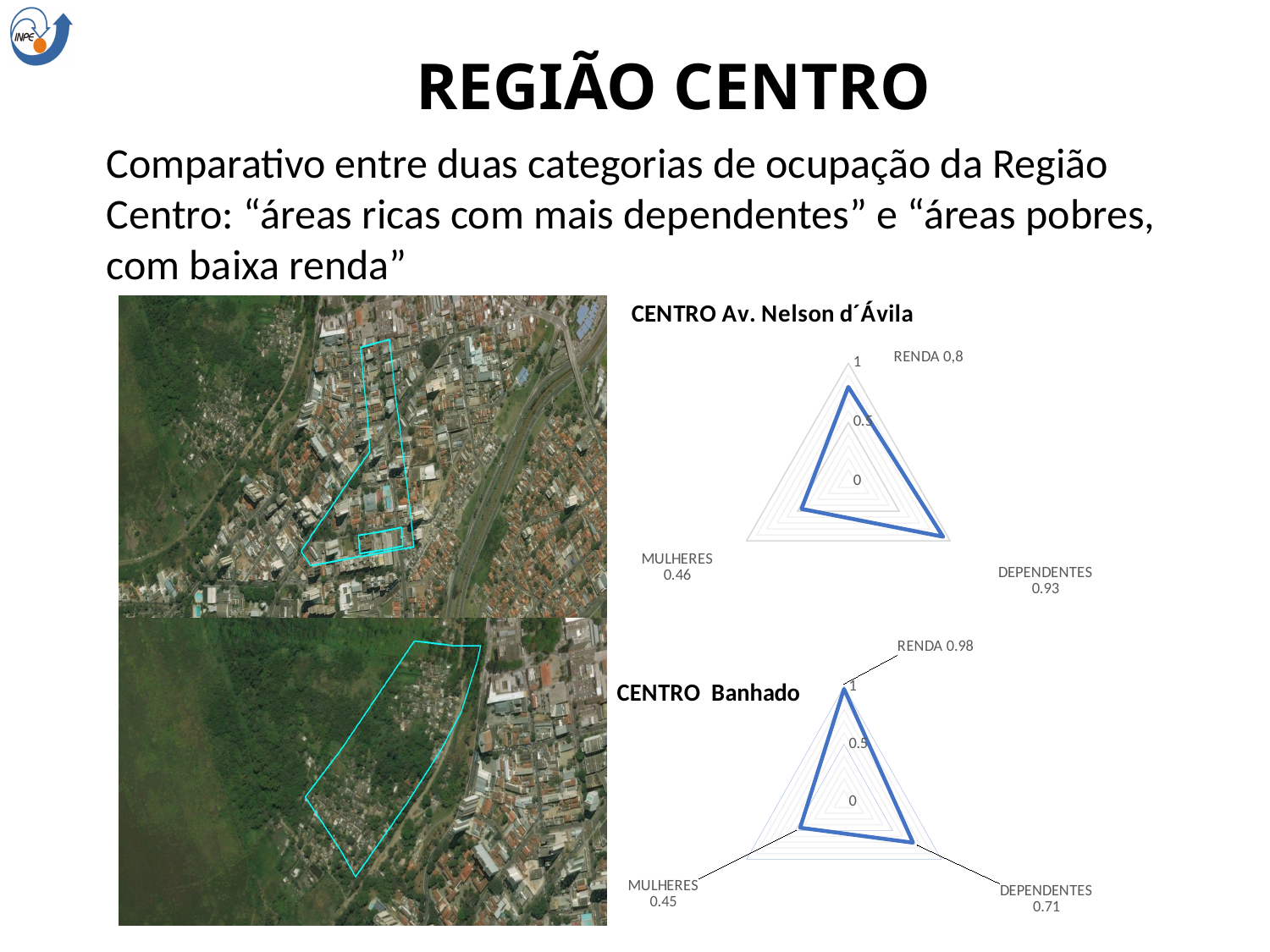
In the CENTRO Banhado chart, what is the value for MULHERES? 0.45 In the CENTRO Banhado chart, what is the value for DEPENDENTES? 0.71 How many categories does the CENTRO Av. Nelson d´Ávila chart plot? 3 In the CENTRO Banhado chart, what is the value for RENDA? 0.98 In the CENTRO Av. Nelson d´Ávila chart, what is the value for MULHERES? 0.46 In the CENTRO Av. Nelson d´Ávila chart, which category has the highest value? DEPENDENTES In the CENTRO Banhado chart, which is larger, RENDA or DEPENDENTES? RENDA In the CENTRO Banhado chart, what is the difference between the RENDA and DEPENDENTES values? 0.27 In the CENTRO Banhado chart, which category has the lowest value? MULHERES What kind of chart is the CENTRO Banhado chart? Radar chart In the CENTRO Av. Nelson d´Ávila chart, what is the value for DEPENDENTES? 0.93 In the CENTRO Av. Nelson d´Ávila chart, what is the value for RENDA? 0,8